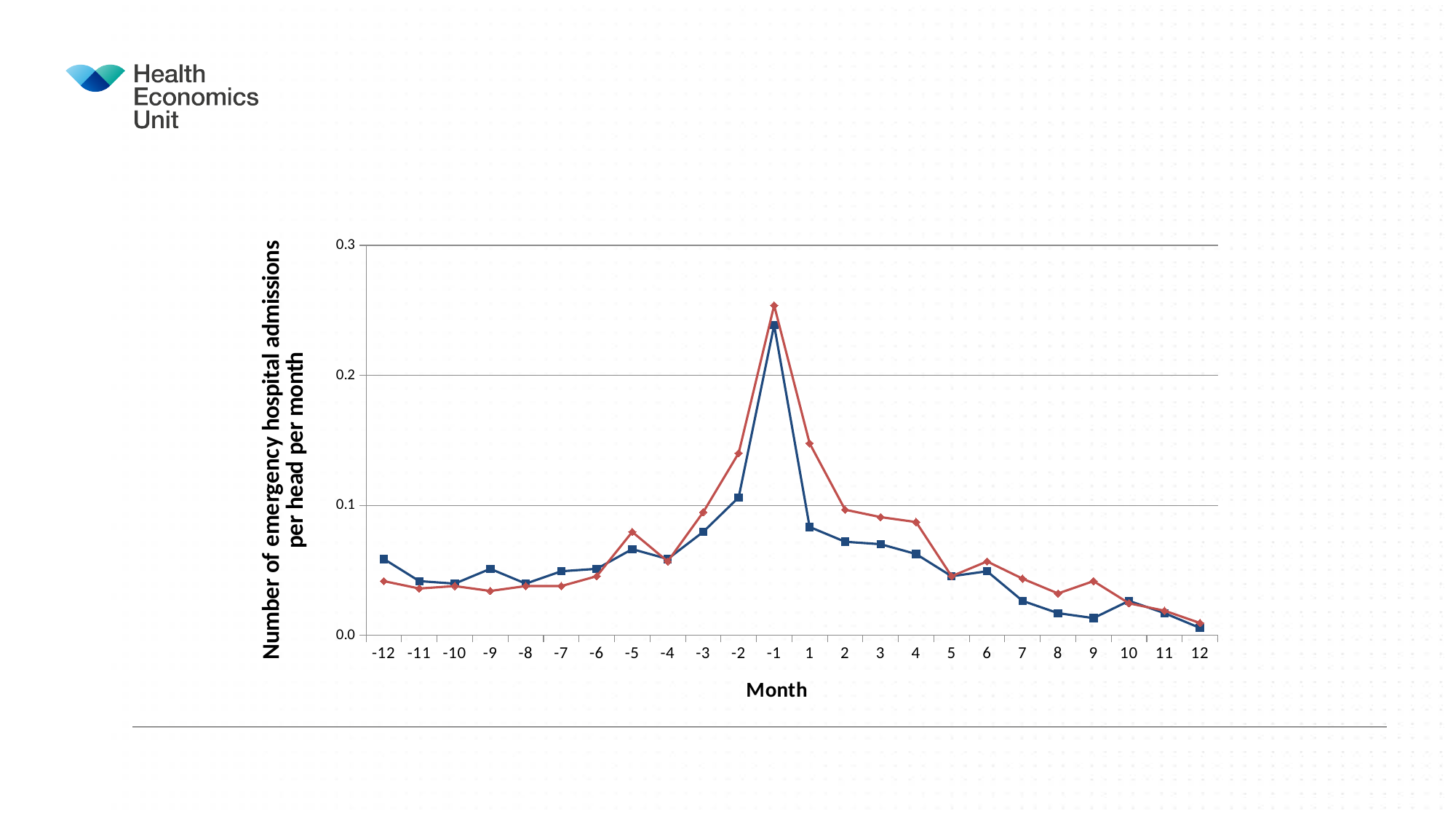
Is the value of the red line at month -1 greater or less than 0.2? greater At month -12, which line has the higher value, the red line or the blue line? blue line At which month does the blue line reach its highest value? -1 What kind of chart is shown on the slide? line chart At which month does the red line reach its highest value? -1 What is the label of the x axis? Month How many lines are plotted on the chart? 2 Is the value of the blue line at month 1 greater or less than 0.1? less How many months are shown along the x axis? 24 At month 1, which line has the higher value, the red line or the blue line? red line Is the value of the red line at month 1 greater or less than 0.1? greater Do the values of the blue line generally rise or fall from month 1 to month 12? fall